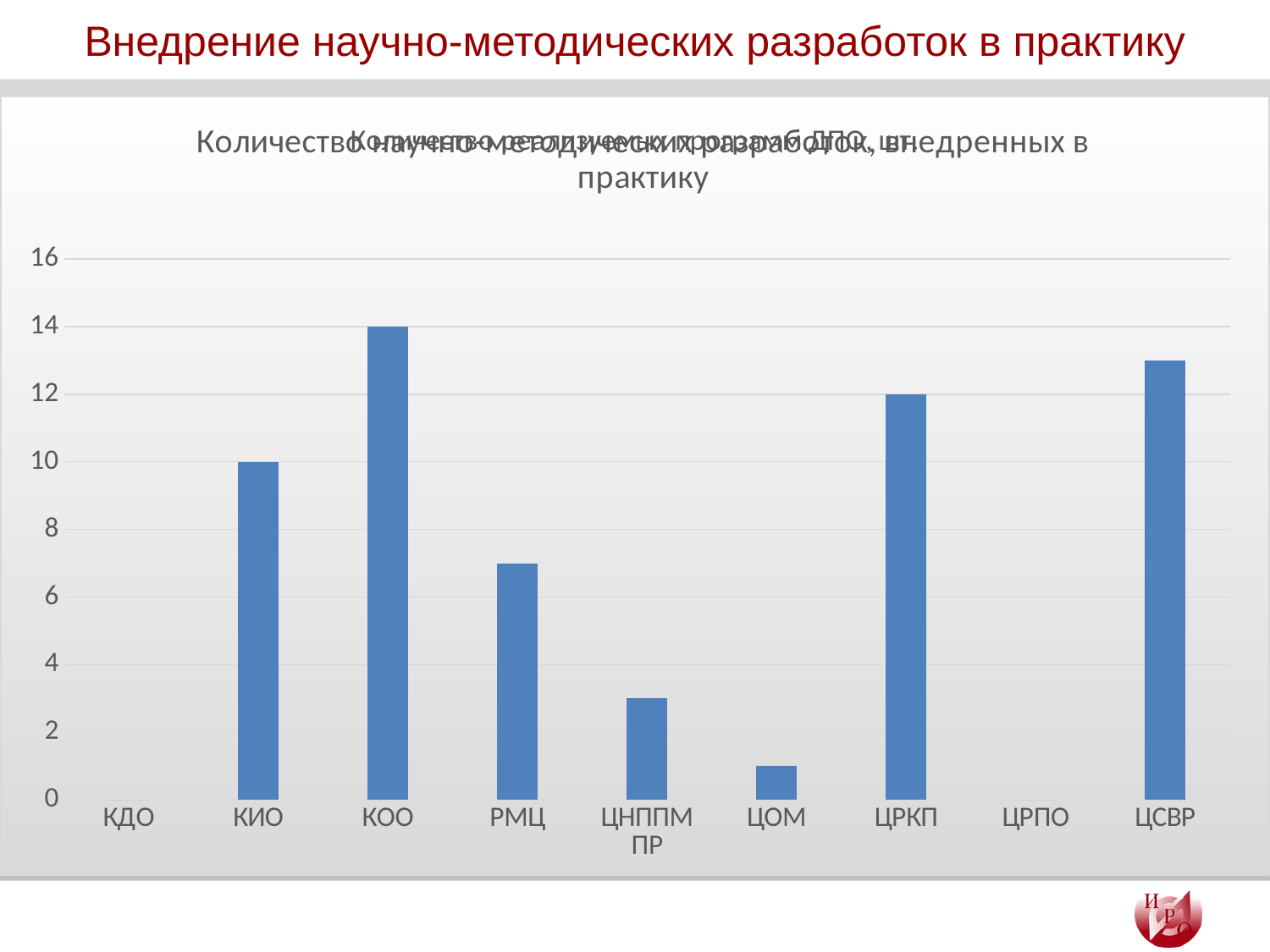
Is the value for РМЦ greater or less than 8? less How many categories are shown on the x axis? 9 What kind of chart is shown on the slide? bar chart Which category has the highest bar? КОО What is the value for КИО? 10 What is the difference between the values for КОО and ЦРКП? 2 Is the value for ЦСВР greater or less than 12? greater Which is larger, the value for КИО or the value for РМЦ? КИО What is the difference between the values for КОО and КИО? 4 Is the value for ЦНППМ ПР greater or less than 4? less What is the value for ЦРКП? 12 What is the value for КОО? 14